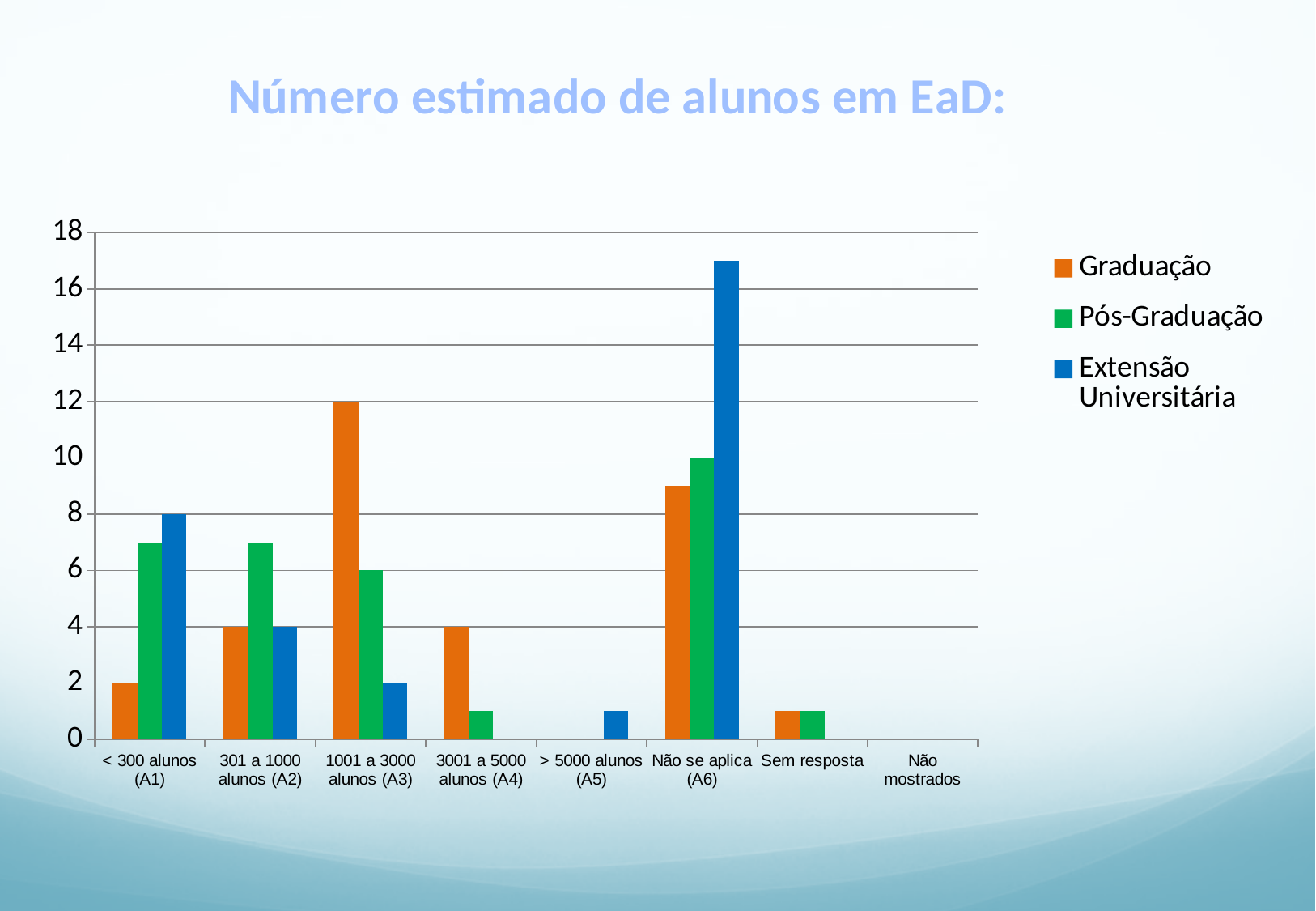
What is the value for Extensão Universitária in the '< 300 alunos (A1)' category? 8 How many series does the legend list? 3 What is the value for Pós-Graduação in the 'Não se aplica (A6)' category? 10 What type of chart is shown on the slide? bar chart Which category has the highest Graduação value? 1001 a 3000 alunos (A3) Which category has the highest Extensão Universitária value? Não se aplica (A6) What is the difference between the Graduação and Pós-Graduação values in the '1001 a 3000 alunos (A3)' category? 6 What is the value for Graduação in the '1001 a 3000 alunos (A3)' category? 12 What is the title of the chart? Número estimado de alunos em EaD: Which is larger in the '< 300 alunos (A1)' category: Graduação or Pós-Graduação? Pós-Graduação Is the value for Extensão Universitária in 'Não se aplica (A6)' greater or less than 16? greater What is the value for Graduação in the '301 a 1000 alunos (A2)' category? 4